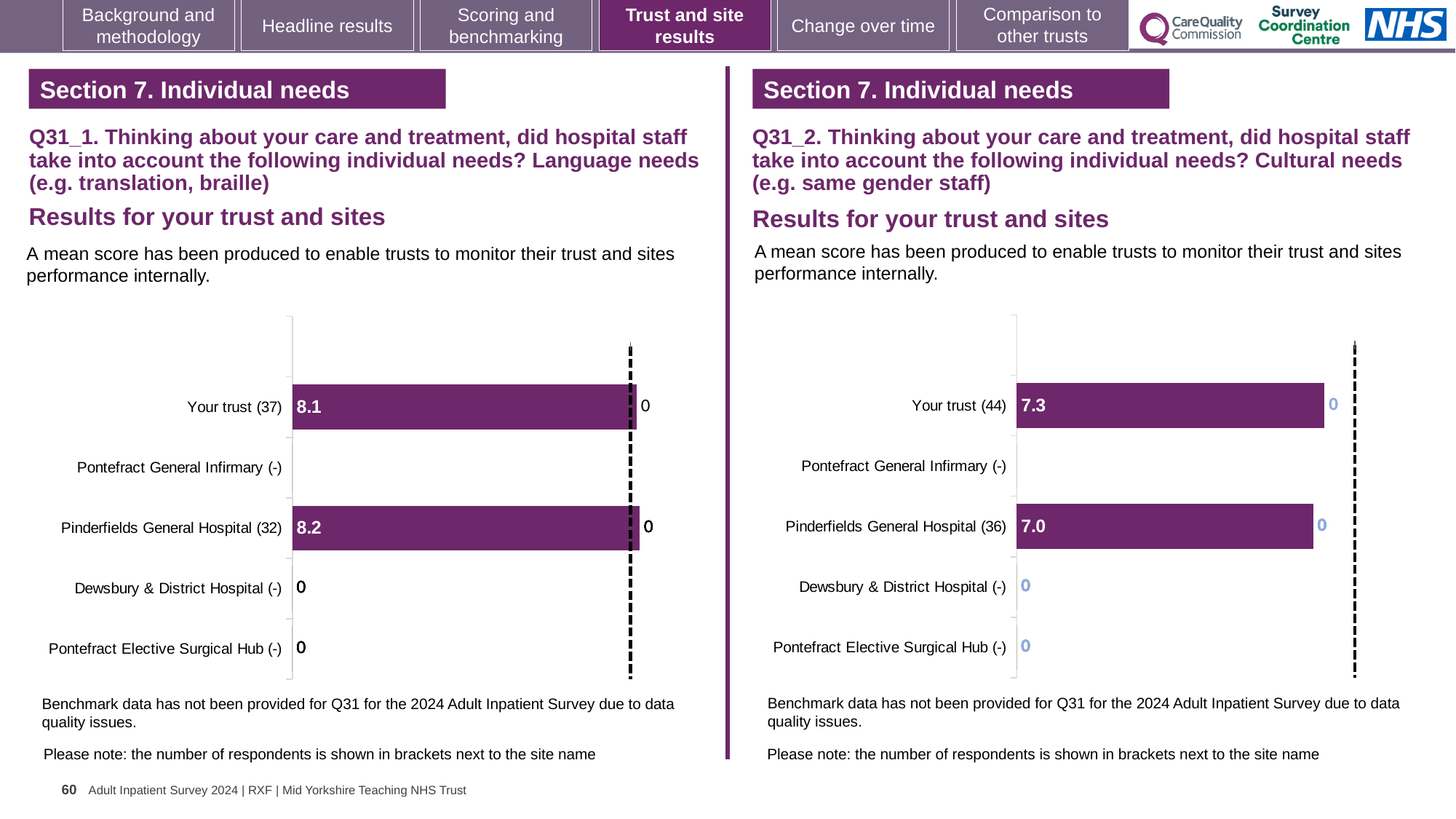
In the Q31_2 Cultural needs chart, what is the mean score for Your trust? 7.3 In the Q31_2 Cultural needs chart, what is the difference between the mean scores for Your trust and Pinderfields General Hospital? 0.3 In the Q31_2 Cultural needs chart, what is the mean score for Pinderfields General Hospital? 7.0 In the Q31_1 Language needs chart, how many sites have a plotted bar with a mean score? 2 How many site categories are listed on the y axis of the Q31_2 Cultural needs chart? 5 In the Q31_1 Language needs chart, what is the mean score for Your trust? 8.1 What type of chart is used in the Q31_1 Language needs chart? Bar chart In the Q31_1 Language needs chart, what is the difference between the mean scores for Pinderfields General Hospital and Your trust? 0.1 In the Q31_2 Cultural needs chart, which has the higher mean score, Your trust or Pinderfields General Hospital? Your trust In the Q31_1 Language needs chart, what is the mean score for Pinderfields General Hospital? 8.2 In the Q31_2 Cultural needs chart, how many respondents are shown in brackets for Pinderfields General Hospital? 36 In the Q31_1 Language needs chart, how many respondents are shown in brackets for Your trust? 37